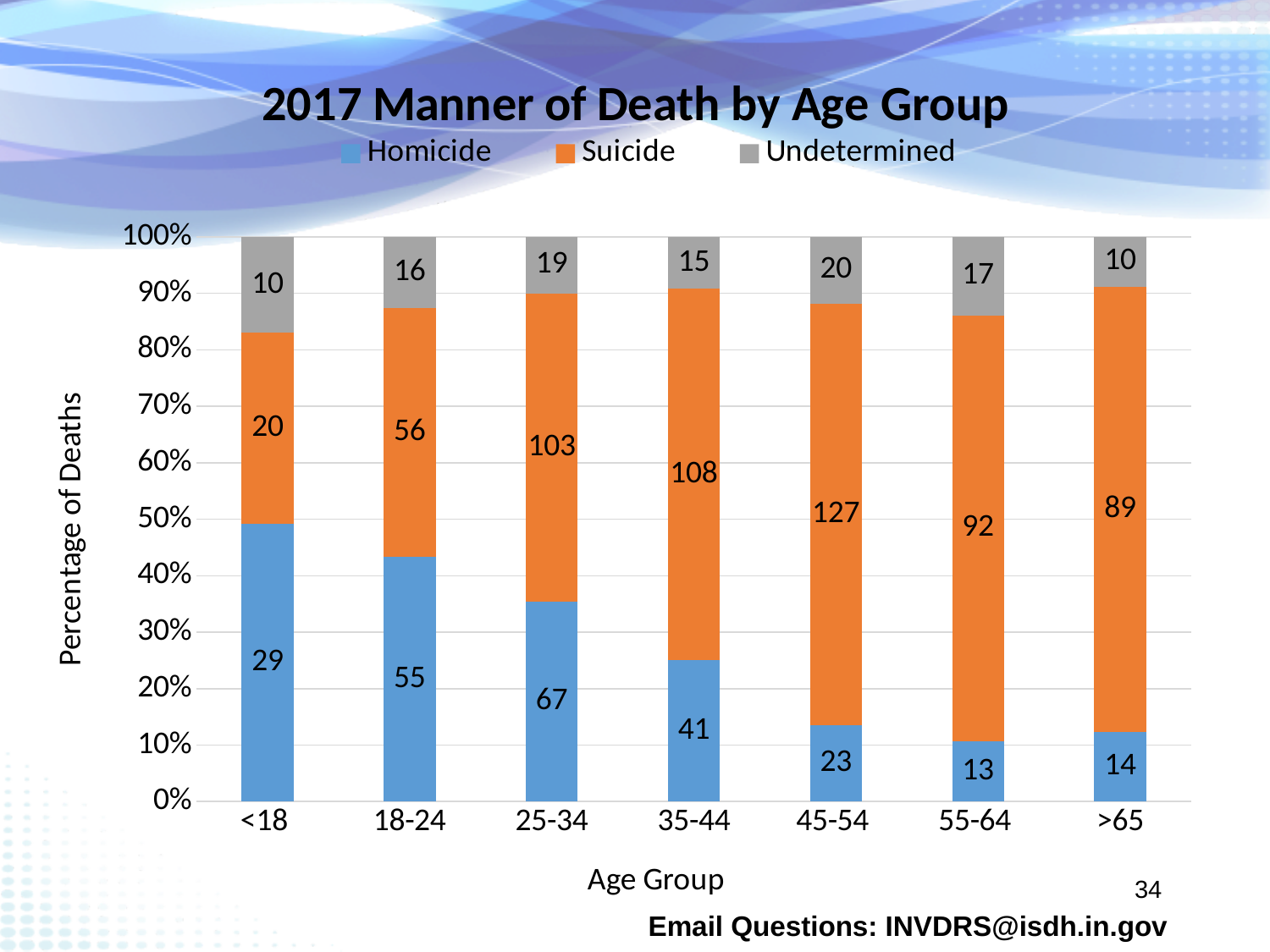
What is the Undetermined value for the 35-44 age group? 15 What is the difference between the Suicide values for the 35-44 and 25-34 age groups? 5 What is the Suicide value for the 45-54 age group? 127 What is the total of the three values in the <18 bar? 59 What is the Homicide value for the 25-34 age group? 67 How many series does the legend list? 3 How many age groups are shown on the x axis? 7 Which age group has the lowest Homicide value? 55-64 What type of chart is shown on the slide? Stacked bar chart Which is larger, the Homicide value for 18-24 or the Homicide value for 35-44? 18-24 Which age group has the highest Suicide value? 45-54 Is the Homicide share of the 18-24 bar greater or less than 50%? less